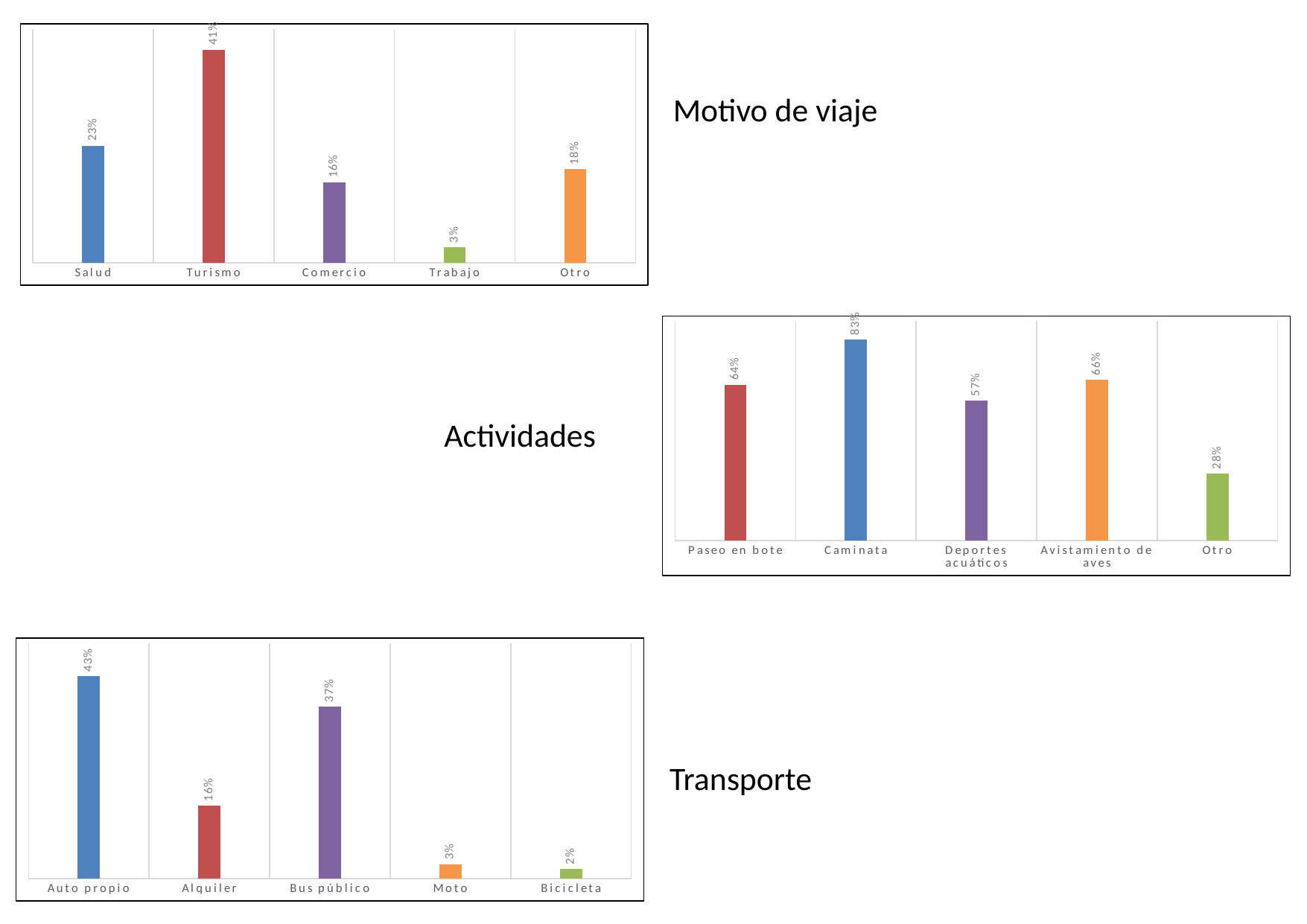
In the Motivo de viaje chart, what is the value for Turismo? 41% In the Actividades chart, which category has the highest value? Caminata In the Actividades chart, what is the difference between Caminata and Otro? 55% How many charts are on the slide? 3 In the Actividades chart, which is larger, Paseo en bote or Deportes acuáticos? Paseo en bote In the Motivo de viaje chart, which category has the lowest value? Trabajo In the Transporte chart, which category has the lowest value? Bicicleta In the Transporte chart, what is the value for Bus público? 37% In the Motivo de viaje chart, what is the difference between Salud and Otro? 5% In the Actividades chart, what is the value for Avistamiento de aves? 66% In the Transporte chart, how many categories are shown? 5 What kind of chart is the Transporte chart? Bar chart